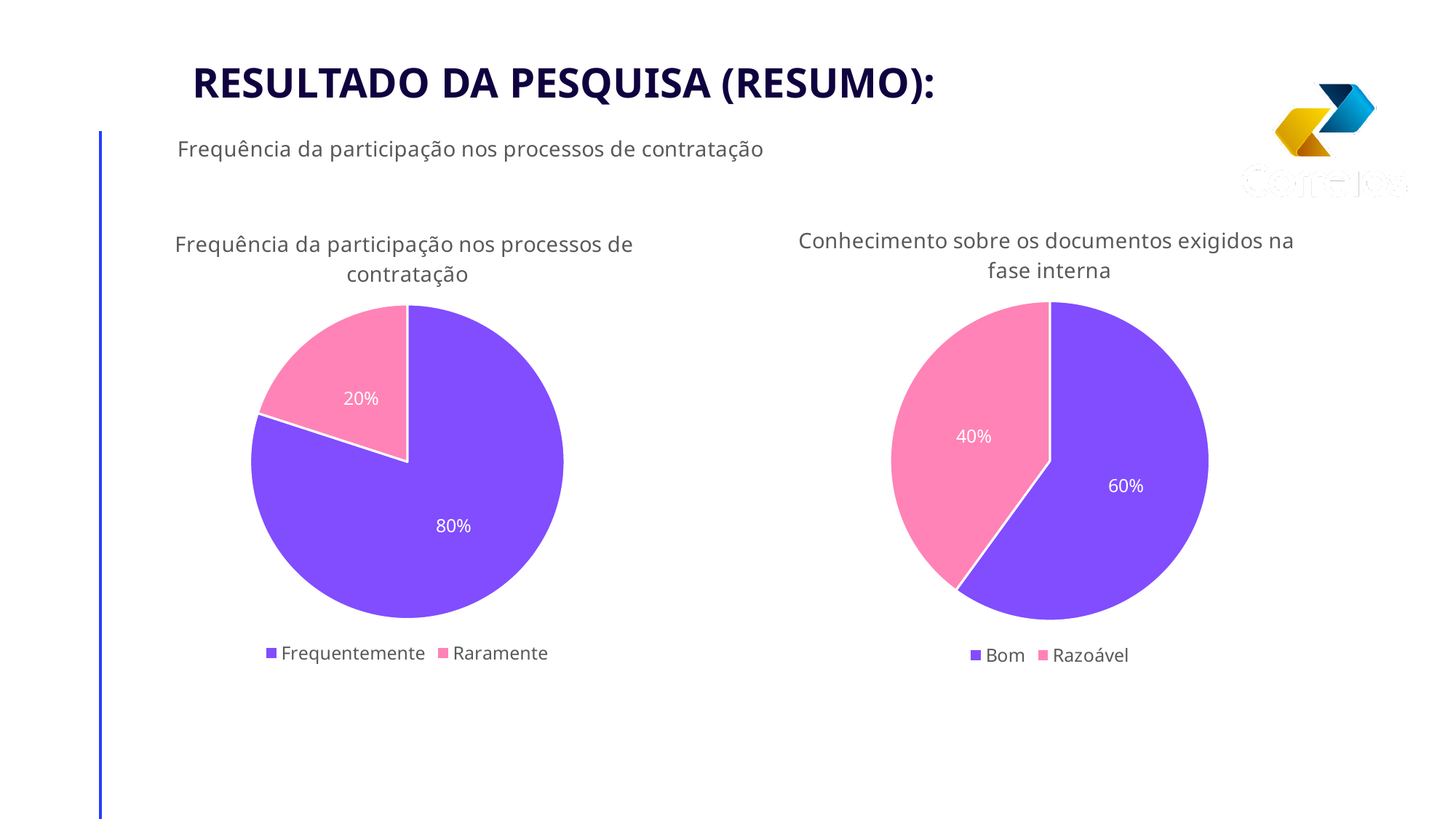
In the left chart 'Frequência da participação nos processos de contratação', what share is labelled for Raramente? 20% In the right chart 'Conhecimento sobre os documentos exigidos na fase interna', which is larger, Bom or Razoável? Bom In the left chart 'Frequência da participação nos processos de contratação', what share is labelled for Frequentemente? 80% In the right chart 'Conhecimento sobre os documentos exigidos na fase interna', what share is labelled for Bom? 60% What kind of chart is the left chart 'Frequência da participação nos processos de contratação'? Pie chart In the right chart 'Conhecimento sobre os documentos exigidos na fase interna', which category has the smallest slice? Razoável In the left chart 'Frequência da participação nos processos de contratação', which category has the largest slice? Frequentemente In the left chart 'Frequência da participação nos processos de contratação', what is the difference between the Frequentemente and Raramente shares? 60% In the right chart 'Conhecimento sobre os documentos exigidos na fase interna', what share is labelled for Razoável? 40% In the right chart 'Conhecimento sobre os documentos exigidos na fase interna', what is the difference between the Bom and Razoável shares? 20% In the left chart 'Frequência da participação nos processos de contratação', what colour is the Raramente slice? Pink How many categories does the right chart 'Conhecimento sobre os documentos exigidos na fase interna' show? 2